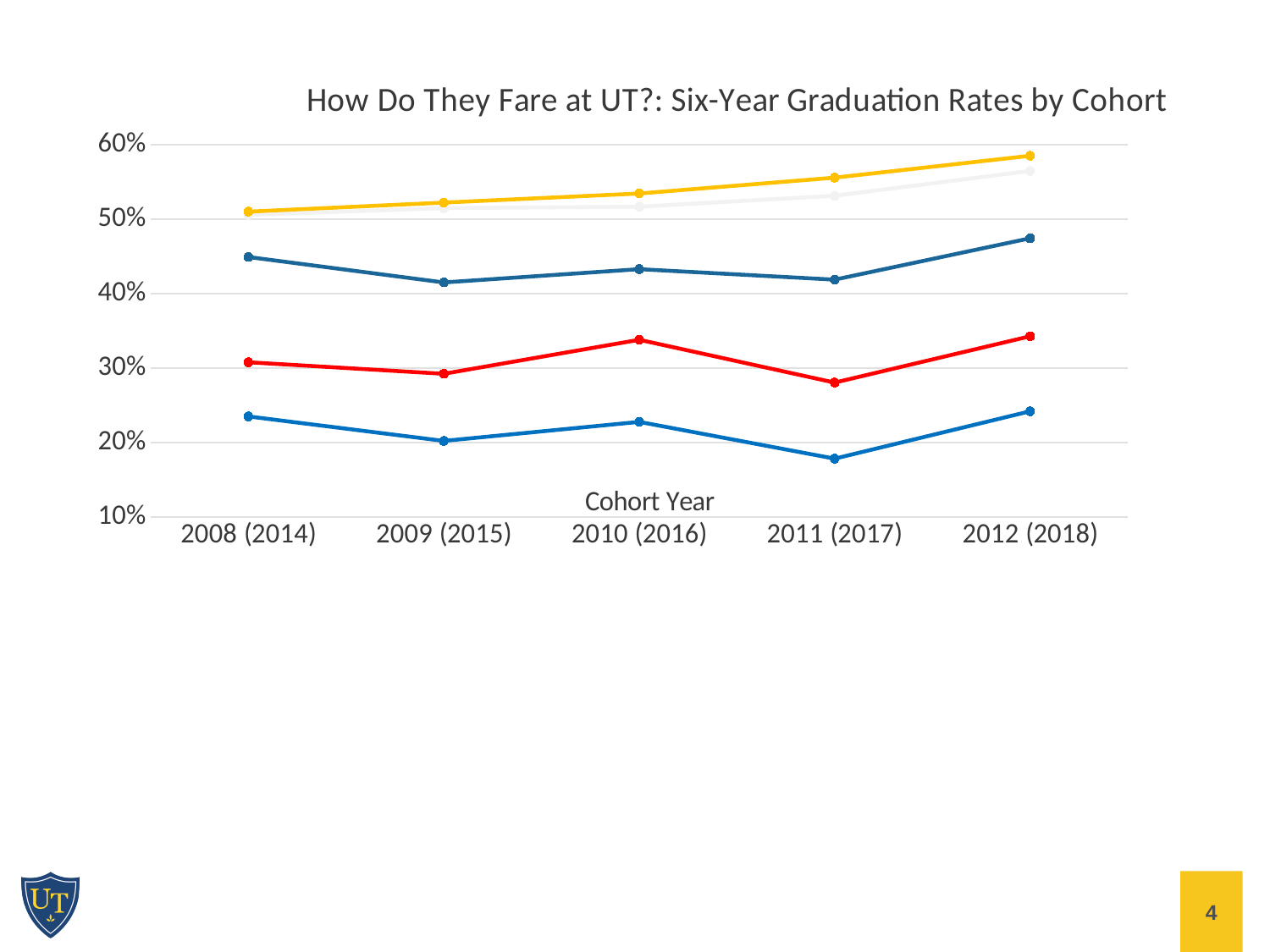
For the light blue (bottom) line, which cohort year has the lowest value? 2011 (2017) Is the value of the dark blue line for 2009 (2015) greater or less than 40%? greater Does the yellow line rise or fall across the cohort years from 2008 (2014) to 2012 (2018)? rise At 2008 (2014), is the dark blue line higher or lower than the red line? higher Is the value of the yellow line for 2012 (2018) greater or less than 50%? greater Is the value of the light blue (bottom) line for 2011 (2017) greater or less than 20%? less What kind of chart is shown on the slide? line chart How many cohort years are plotted along the x axis? 5 For the red line, which cohort year has the lowest value? 2011 (2017) What is the title of the chart? How Do They Fare at UT?: Six-Year Graduation Rates by Cohort What is the label of the x axis? Cohort Year